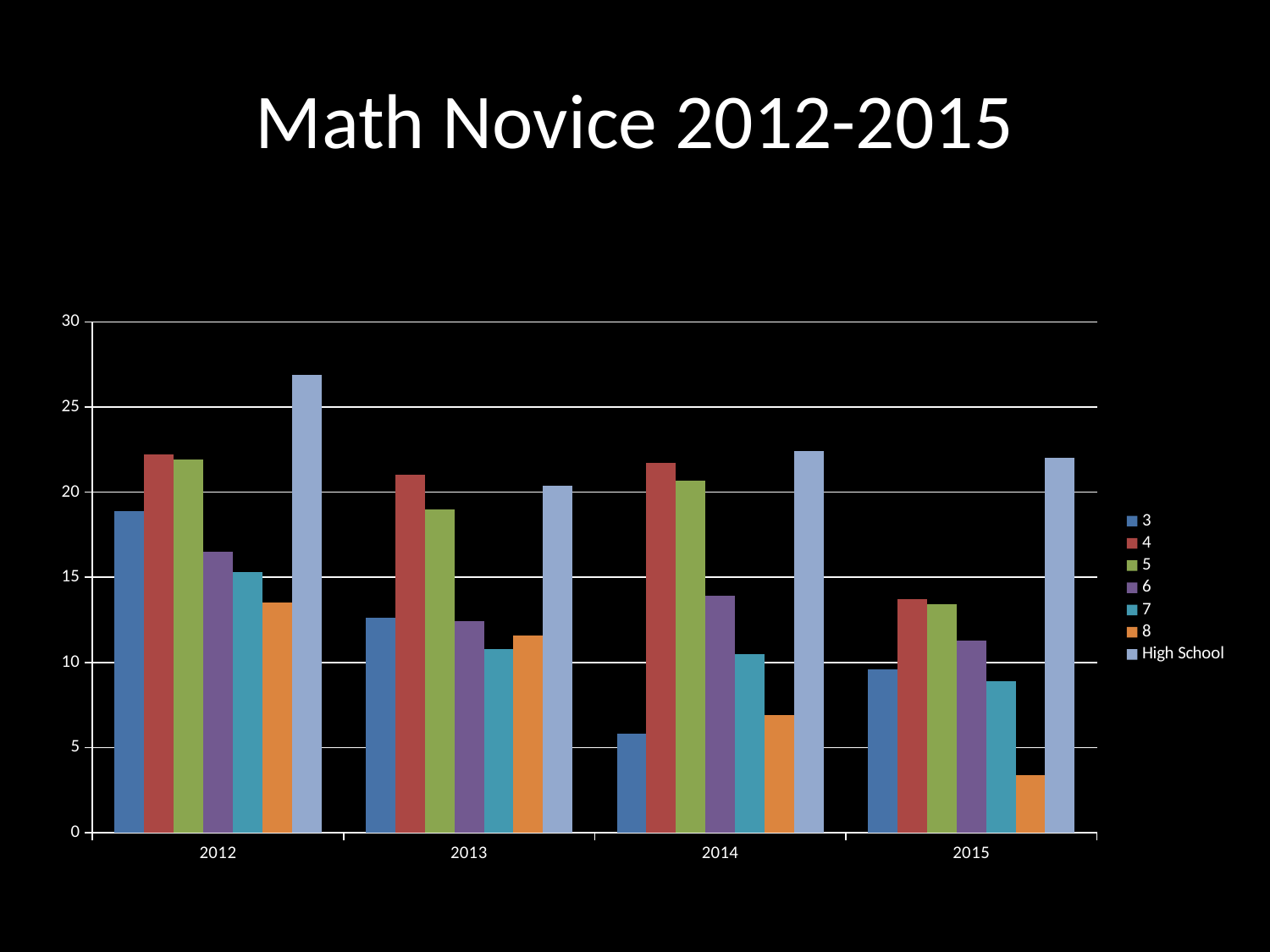
In 2013, which is larger, the value for grade 4 or the value for grade 3? 4 Is the value for grade 3 in 2014 greater or less than 10? less Do the values for grade 8 rise or fall from 2012 to 2015? fall Is the value for High School in 2012 greater or less than 25? greater Is the value for grade 8 in 2015 greater or less than 5? less How many series does the legend list? 7 Which series has the lowest value in 2014? 3 Which series has the lowest value in 2015? 8 What kind of chart is shown on the slide? bar chart How many years are shown along the x axis? 4 What is the title of the chart? Math Novice 2012-2015 Which series has the highest value in 2012? High School